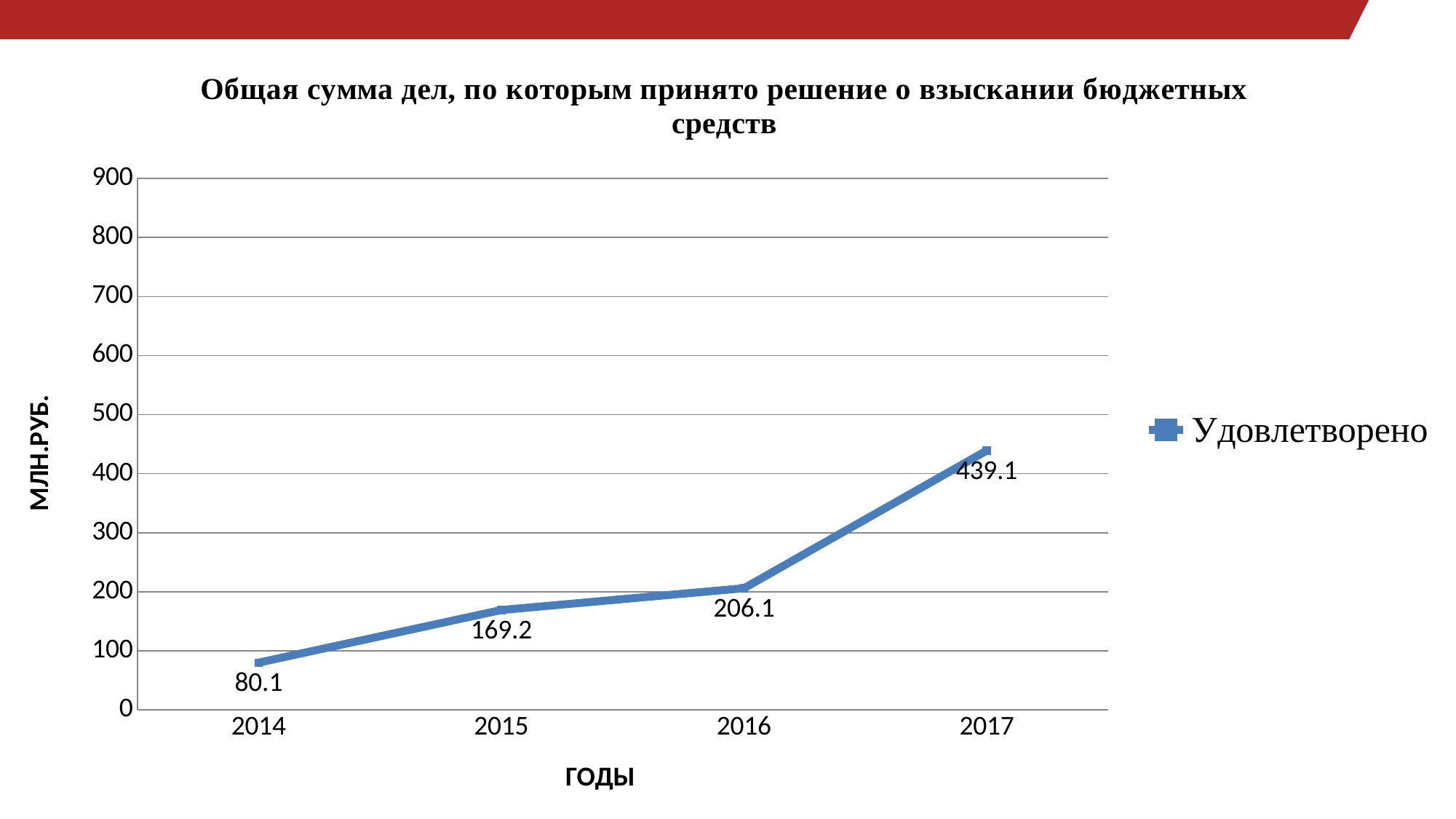
What is the value for 2014? 80.1 What is the difference between the values for 2017 and 2016? 233 Which is larger, the value for 2015 or the value for 2016? 2016 What kind of chart is shown? line chart What is the value for 2016? 206.1 How many years are plotted on the x axis? 4 Which year has the lowest value? 2014 Which year has the highest value? 2017 What is the value for 2017? 439.1 What is the value for 2015? 169.2 Is the value for 2017 greater or less than 400? greater Do the values rise or fall from 2014 to 2017? rise